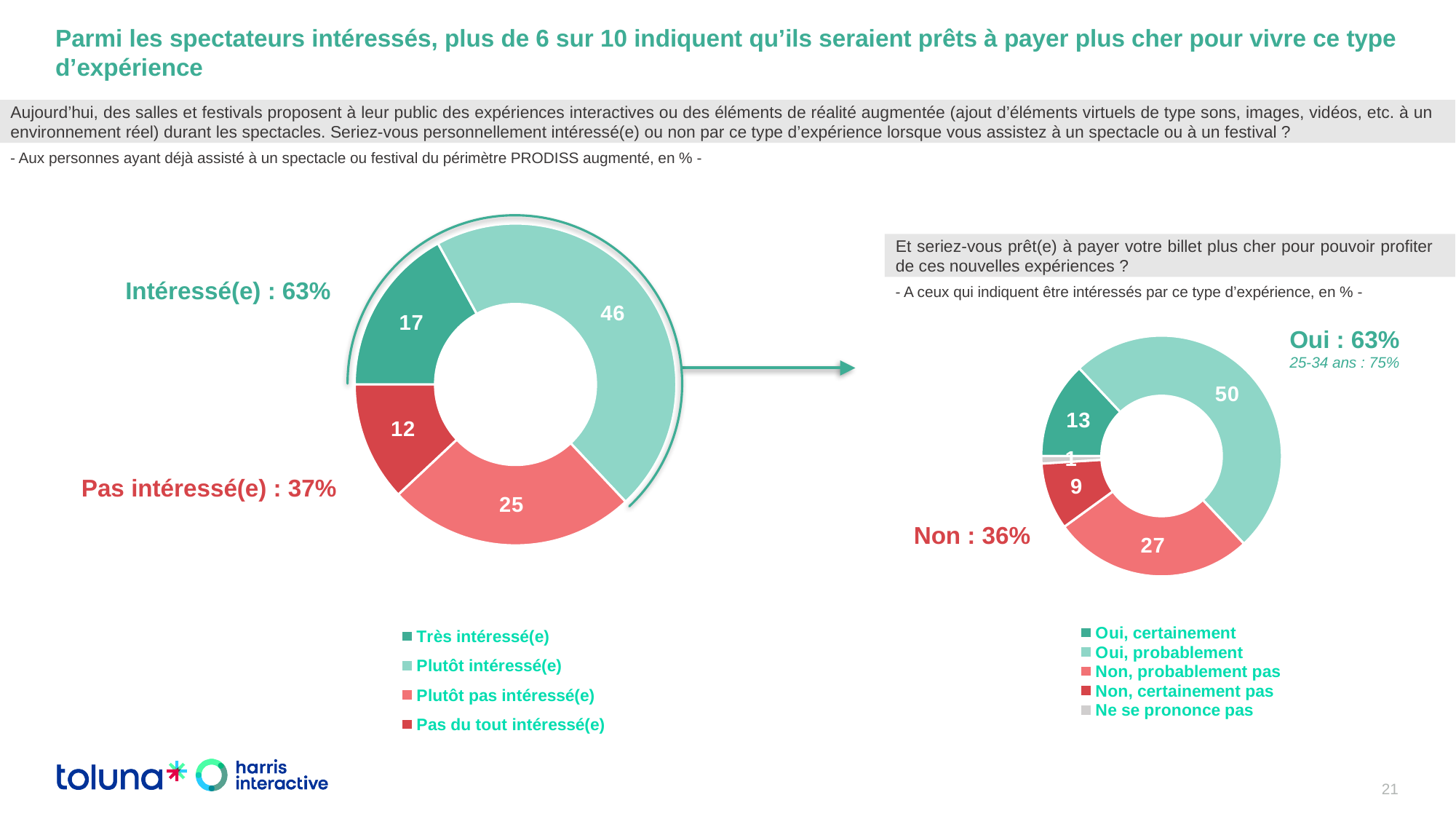
In the right chart, how many categories does the legend list? 5 In the right chart, what is the total of "Non, probablement pas" and "Non, certainement pas"? 36 In the right chart, what is the value for "Oui, probablement"? 50 What kind of chart is the left chart? Donut (pie) chart In the right chart, what is the value for "Ne se prononce pas"? 1 In the left chart, what is the value for "Pas du tout intéressé(e)"? 12 In the left chart, which category has the largest slice? Plutôt intéressé(e) In the left chart, what is the difference between "Plutôt pas intéressé(e)" and "Très intéressé(e)"? 8 In the right chart, which category has the smallest slice? Ne se prononce pas In the left chart, what is the value for "Plutôt intéressé(e)"? 46 In the right chart, which is larger: "Oui, certainement" or "Non, certainement pas"? Oui, certainement In the left chart, how many categories does the legend list? 4